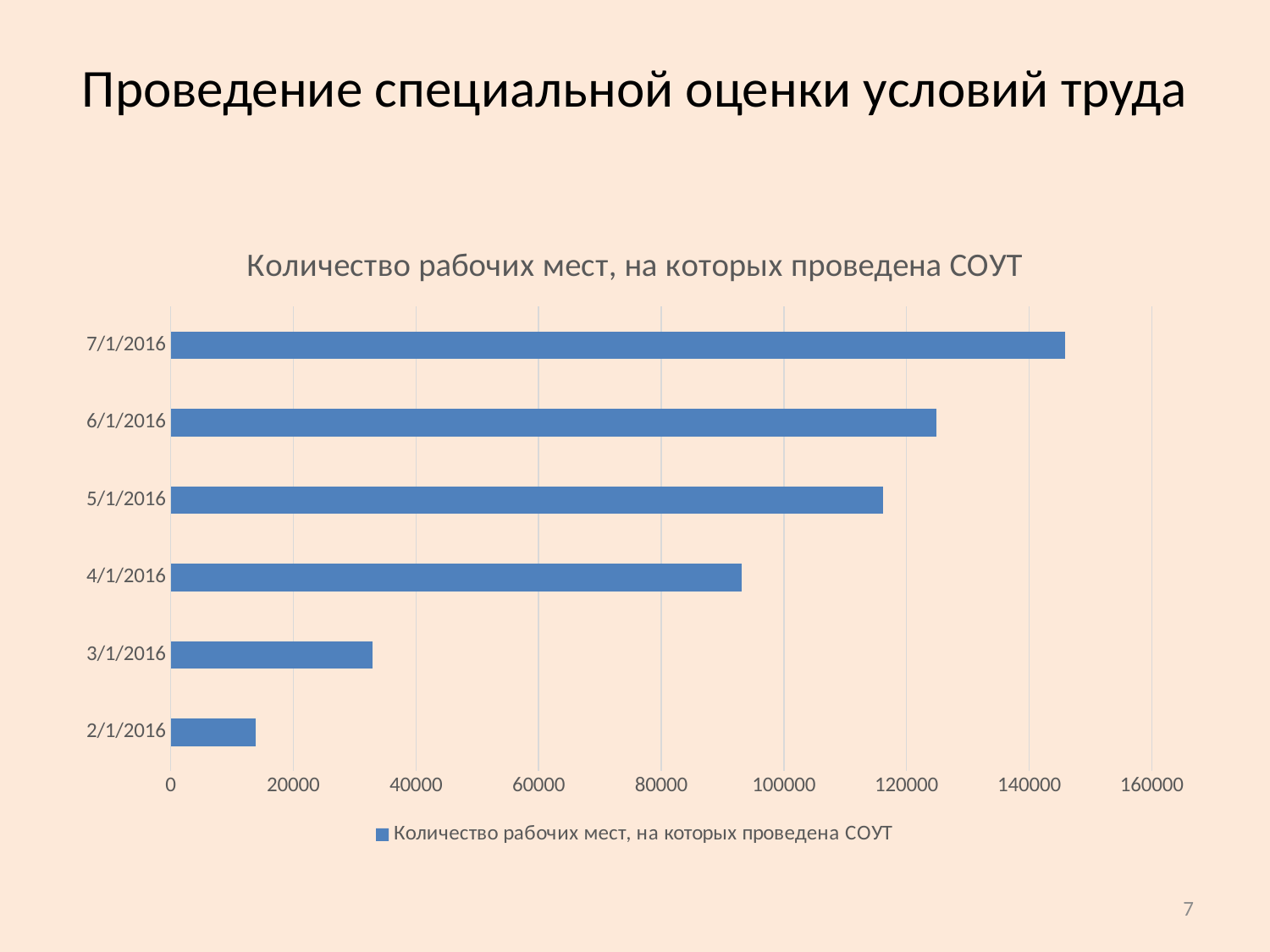
Which date has the highest value? 7/1/2016 Is the value for 5/1/2016 greater or less than 120000? less Is the value for 2/1/2016 greater or less than 20000? less Is the value for 4/1/2016 greater or less than 80000? greater What kind of chart is shown on the slide? bar chart Which date has the lowest value? 2/1/2016 How many series does the legend list? 1 Which is larger, the value for 3/1/2016 or the value for 4/1/2016? 4/1/2016 What is the title of the chart? Количество рабочих мест, на которых проведена СОУТ Do the values rise or fall from 2/1/2016 to 7/1/2016? rise How many categories (dates) are shown in the chart? 6